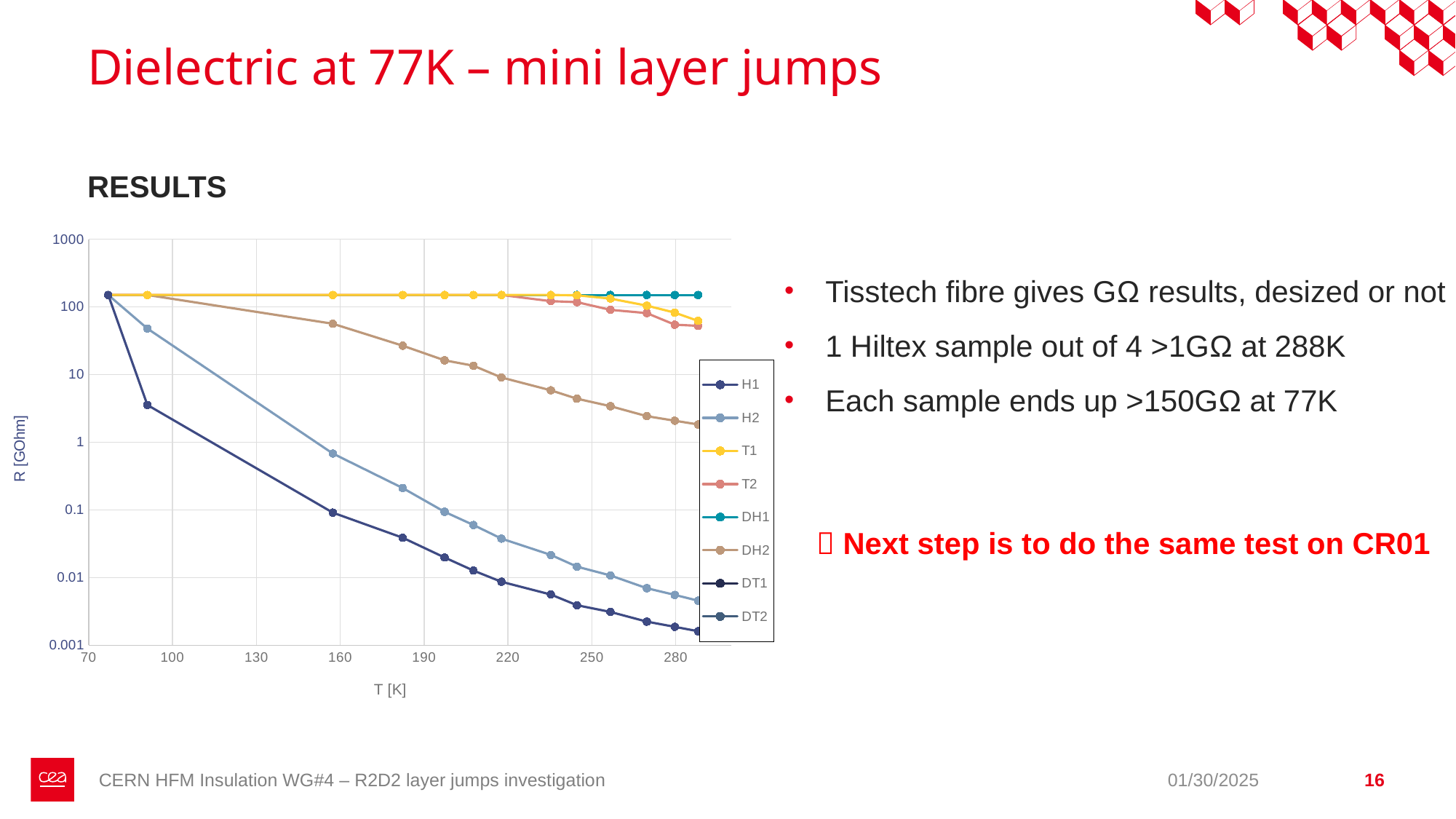
What is the label of the x axis of the chart? T [K] Is the value of the DH2 series at 280 K greater or less than 1? greater What kind of chart is shown on the slide? line chart How many series does the chart legend list? 8 Is the value of the H2 series at 160 K greater or less than 1? less Does the DH2 series rise or fall as T increases along the x axis? fall What is the label of the y axis of the chart? R [GOhm] Is the value of the H2 series at 280 K greater or less than 0.01? less At 220 K, which series has the larger value, DH2 or H2? DH2 Does the H2 series rise or fall as T increases along the x axis? fall